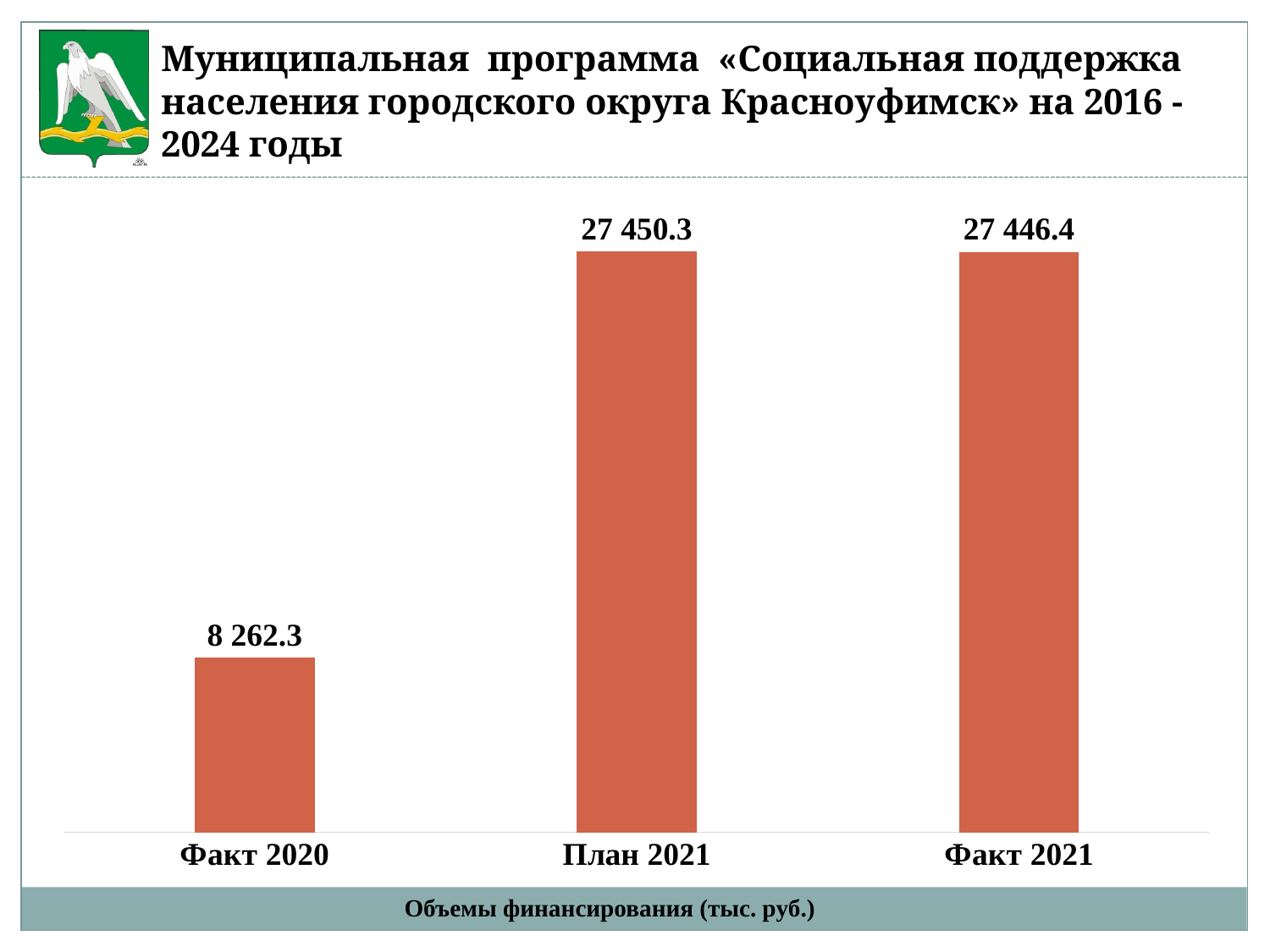
What kind of chart is shown on the slide? Bar chart Which category has the lowest value? Факт 2020 What is the value for Факт 2020? 8 262.3 What is the title of the chart? Объемы финансирования (тыс. руб.) What unit is stated in the chart title? тыс. руб. What is the difference between the values for Факт 2021 and Факт 2020? 19 184.1 What is the difference between the values for План 2021 and Факт 2021? 3.9 Which is larger, the value for Факт 2020 or the value for Факт 2021? Факт 2021 What is the value for План 2021? 27 450.3 What is the value for Факт 2021? 27 446.4 How many categories are shown on the chart? 3 Does the value rise or fall from Факт 2020 to План 2021? Rise